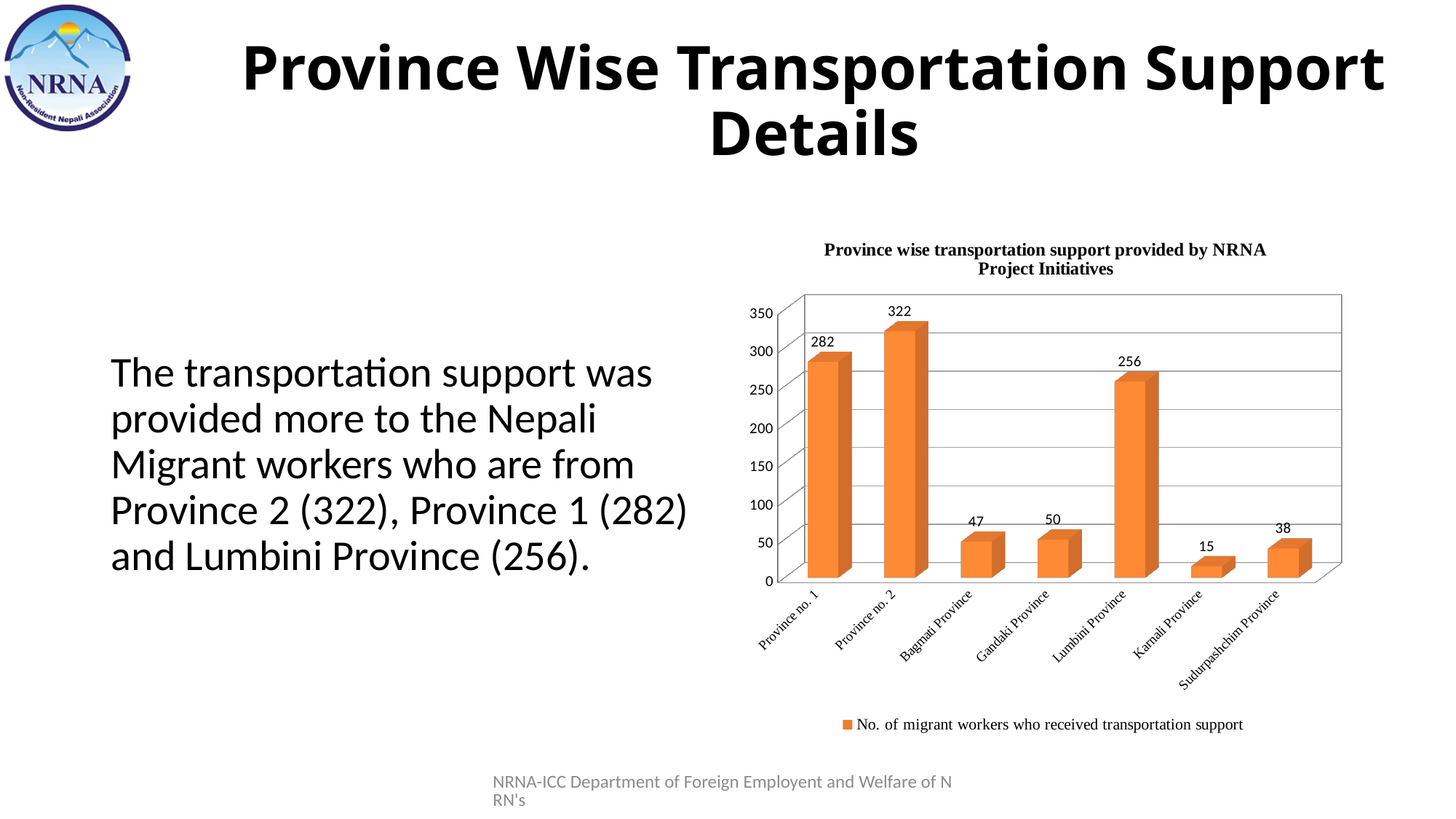
What is the value for Province no. 2? 322 Which province has the highest number of migrant workers who received transportation support? Province no. 2 What is the difference between the values for Province no. 2 and Province no. 1? 40 Which is larger, the value for Bagmati Province or Gandaki Province? Gandaki Province How many provinces are shown on the x axis? 7 Which province has the lowest number of migrant workers who received transportation support? Karnali Province What is the value for Lumbini Province? 256 What is the legend entry of the chart? No. of migrant workers who received transportation support What is the value for Sudurpashchim Province? 38 What is the value for Karnali Province? 15 Is the value for Lumbini Province greater or less than 200? greater What kind of chart is shown on the slide? bar chart